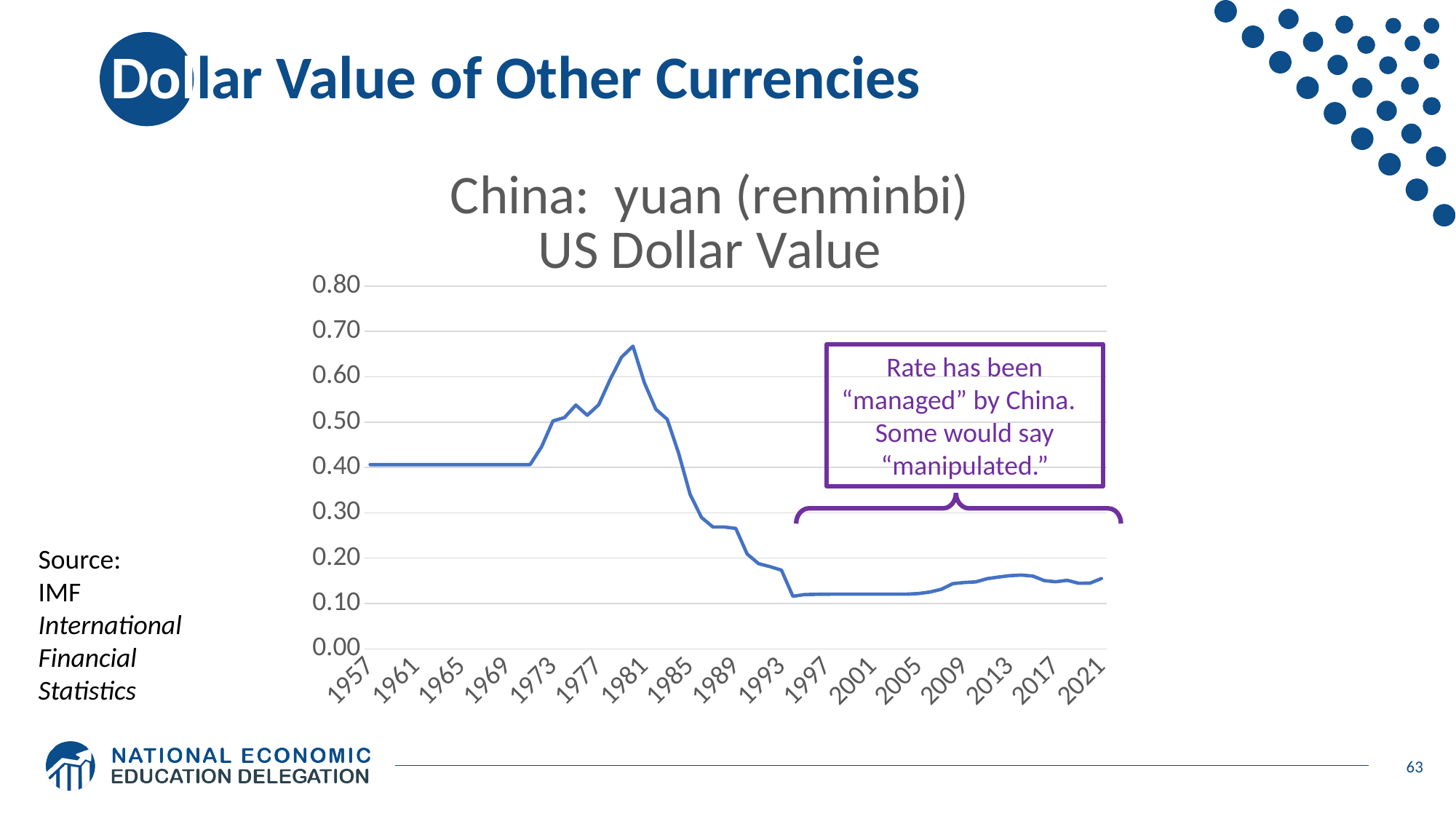
Is the value for 1989 greater or less than 0.30? less Is the value for 1997 greater or less than 0.20? less What is the highest value shown on the y axis? 0.80 Is the value for 2021 greater or less than 0.20? less What kind of chart is shown on the slide? line chart Does the value rise or fall between 1981 and 1993? fall How many year labels are shown on the x axis? 17 What is the title of the chart? China: yuan (renminbi) US Dollar Value Does the value rise or fall between 1969 and 1981? rise